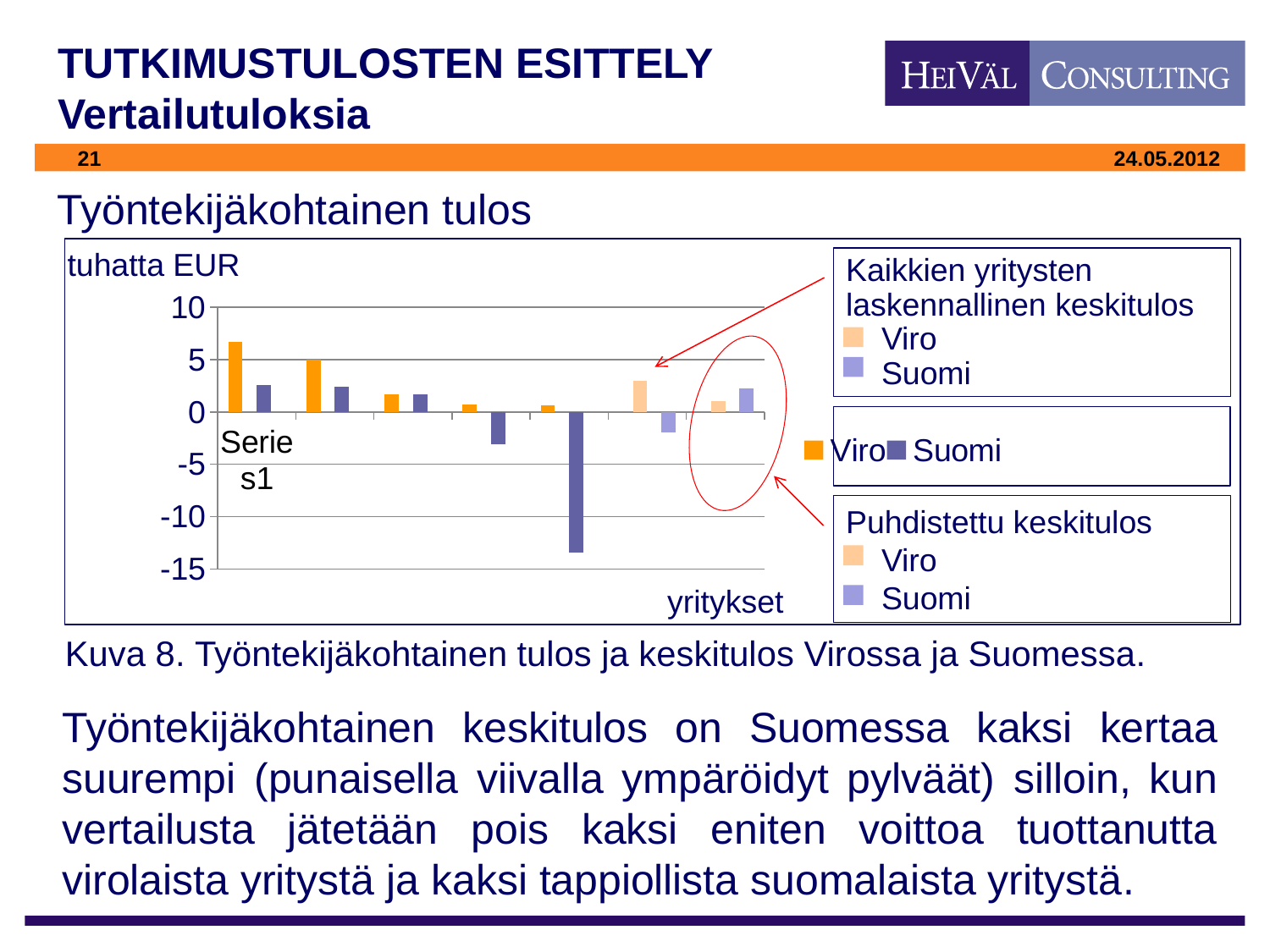
What unit label is shown at the top of the chart's vertical axis? tuhatta EUR Is the lowest Suomi bar greater or less than -10? less Is the tallest Viro bar greater or less than 5? greater Is the tallest Viro bar greater or less than 10? less What is the lowest value shown on the chart's vertical axis? -15 How many series does the chart legend list? 2 Which series, Viro or Suomi, has the lowest (most negative) bar in the chart? Suomi What kind of chart is shown on the slide? bar chart What are the two series named in the chart legend? Viro and Suomi Which series, Viro or Suomi, has the tallest bar in the chart? Viro